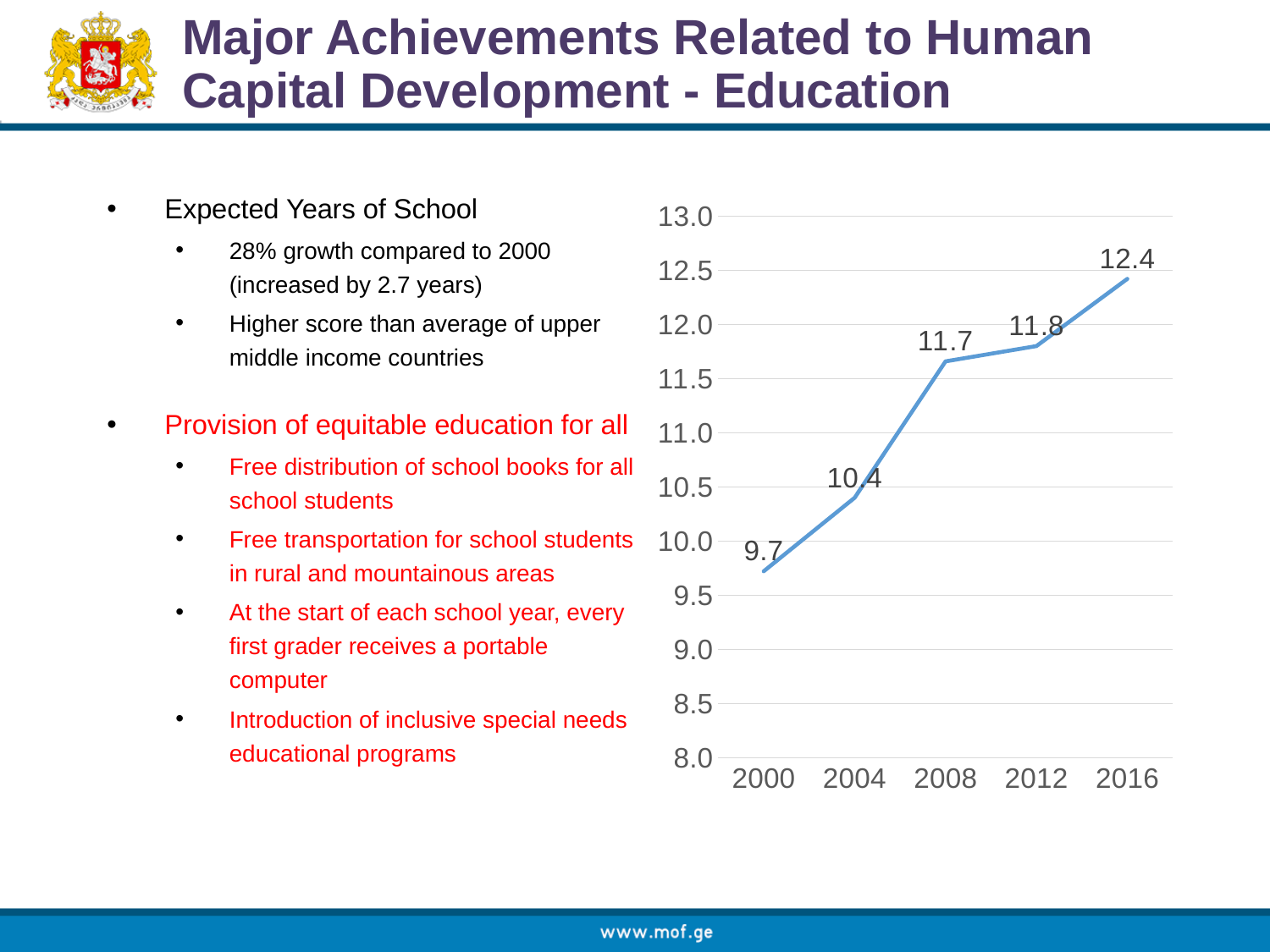
What is the value plotted for 2016? 12.4 Do the values rise or fall from 2000 to 2016? rise Which is larger, the value for 2012 or the value for 2004? 2012 What is the value plotted for 2008? 11.7 How many data points are plotted on the chart? 5 What kind of chart is shown on the slide? line chart What is the difference between the values for 2008 and 2004? 1.3 Which year has the highest value on the chart? 2016 What is the value plotted for 2000? 9.7 Is the value for 2004 greater or less than 11.0? less Which year has the lowest value on the chart? 2000 What is the difference between the values for 2016 and 2000? 2.7